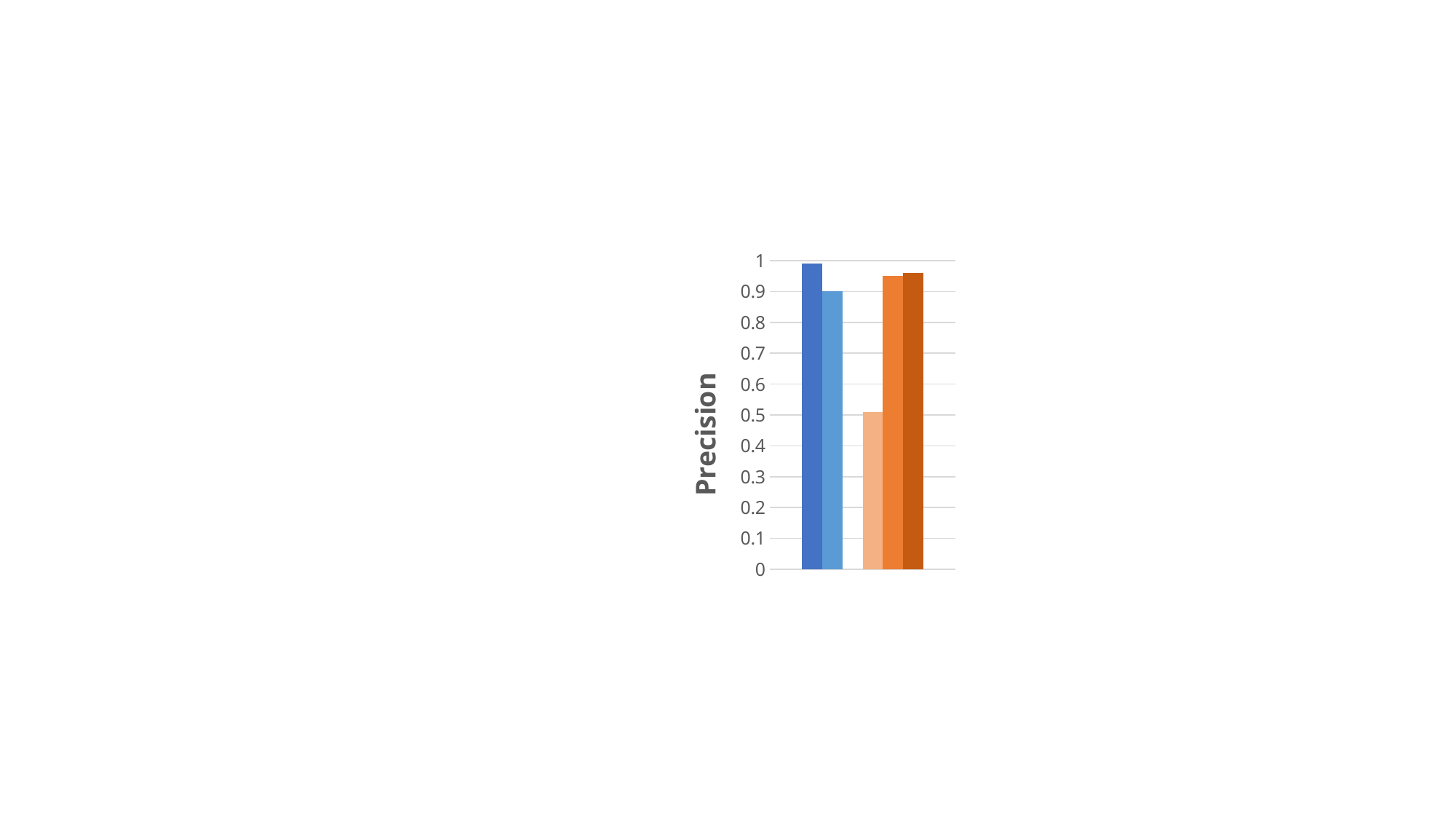
What is the maximum value shown on the vertical axis? 1 Is the value of the dark blue bar greater or less than 0.9? greater Is the value of the light blue bar greater or less than 0.8? greater How many bars are plotted in the chart? 5 Which bar is the lowest in the chart? the light orange bar What kind of chart is shown on the slide? bar chart Is the value of the darkest orange bar greater or less than 0.9? greater Which is larger, the dark blue bar or the light orange bar? the dark blue bar What is the title of the vertical axis? Precision Which is larger, the light orange bar or the light blue bar? the light blue bar